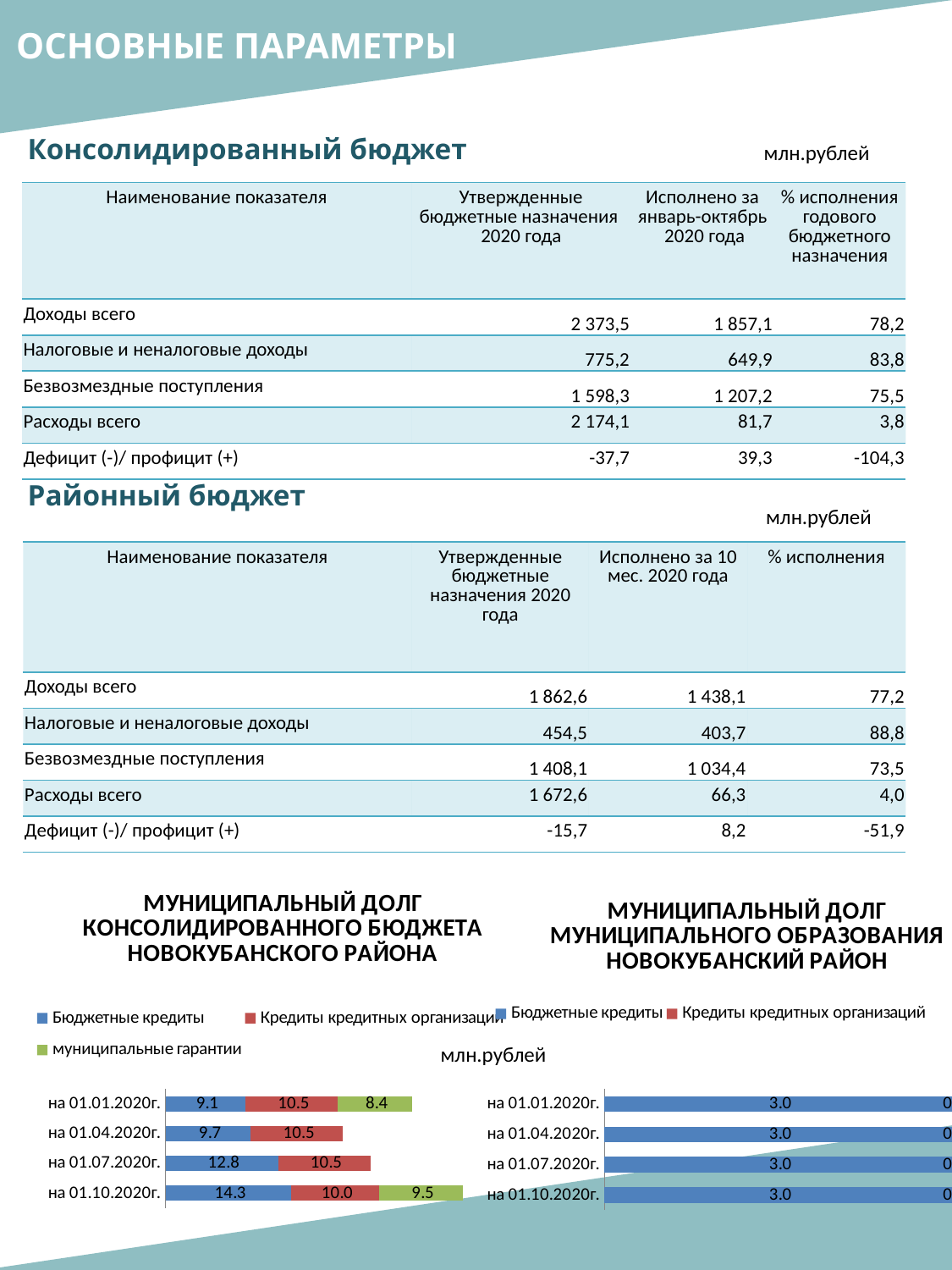
In the right chart (Муниципальный долг муниципального образования Новокубанский район), how does the value of Бюджетные кредиты change across the dates? It stays the same at 3.0 In the left chart (Муниципальный долг консолидированного бюджета Новокубанского района), on which date is the value of Бюджетные кредиты the lowest? на 01.01.2020г. In the left chart (Муниципальный долг консолидированного бюджета Новокубанского района), what is the total of the stacked bar for 01.01.2020? 28.0 In the left chart (Муниципальный долг консолидированного бюджета Новокубанского района), what is the difference between Бюджетные кредиты on 01.10.2020 and on 01.01.2020? 5.2 In the left chart (Муниципальный долг консолидированного бюджета Новокубанского района), what is the value of муниципальные гарантии on 01.01.2020? 8.4 In the left chart (Муниципальный долг консолидированного бюджета Новокубанского района), how many series does the legend list? 3 In the left chart (Муниципальный долг консолидированного бюджета Новокубанского района), what is the value of Кредиты кредитных организаций on 01.07.2020? 10.5 In the left chart (Муниципальный долг консолидированного бюджета Новокубанского района), on which date is the value of Бюджетные кредиты the highest? на 01.10.2020г. In the left chart (Муниципальный долг консолидированного бюджета Новокубанского района), what is the total of the stacked bar for 01.10.2020? 33.8 In the right chart (Муниципальный долг муниципального образования Новокубанский район), what is the value of Бюджетные кредиты on 01.04.2020? 3.0 What type of chart is the right chart (Муниципальный долг муниципального образования Новокубанский район)? Bar chart In the left chart (Муниципальный долг консолидированного бюджета Новокубанского района), what is the value of Бюджетные кредиты on 01.10.2020? 14.3